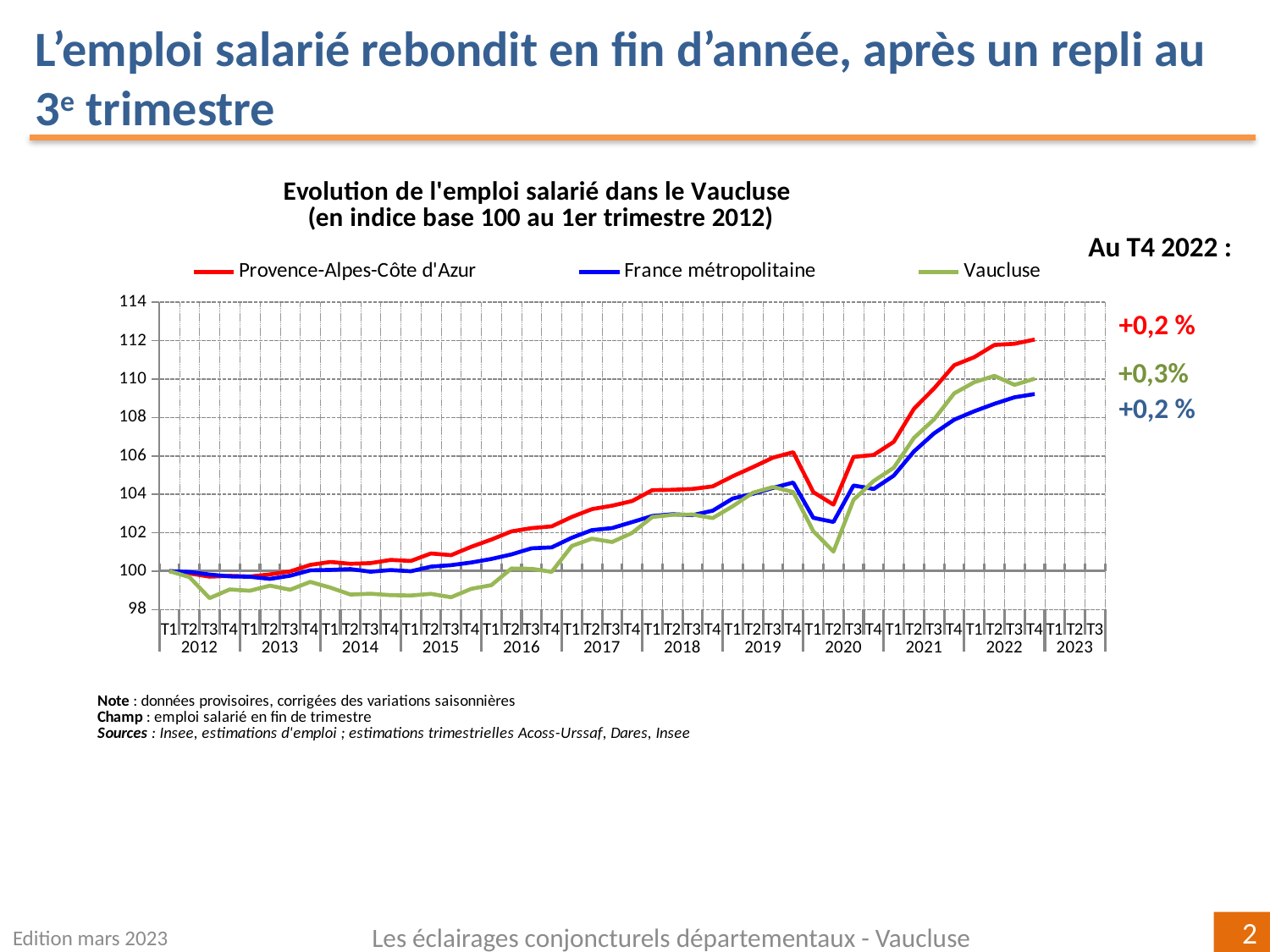
What is the title of the chart? Evolution de l'emploi salarié dans le Vaucluse (en indice base 100 au 1er trimestre 2012) Is the value for Vaucluse at T3 2012 greater or less than 100? less Which series is drawn in green? Vaucluse What is the index value of all three series at T1 2012? 100 Is the value for Vaucluse at T4 2022 greater or less than 108? greater According to the annotation, what is the change for Vaucluse at T4 2022? +0,3% How many series does the legend list? 3 What kind of chart is shown on the slide? line chart According to the annotation, what is the change for Provence-Alpes-Côte d'Azur at T4 2022? +0,2 % Which series has the highest value at T4 2022? Provence-Alpes-Côte d'Azur At T2 2020, which is higher: Provence-Alpes-Côte d'Azur or Vaucluse? Provence-Alpes-Côte d'Azur Is the value for Provence-Alpes-Côte d'Azur at T4 2022 greater or less than 110? greater